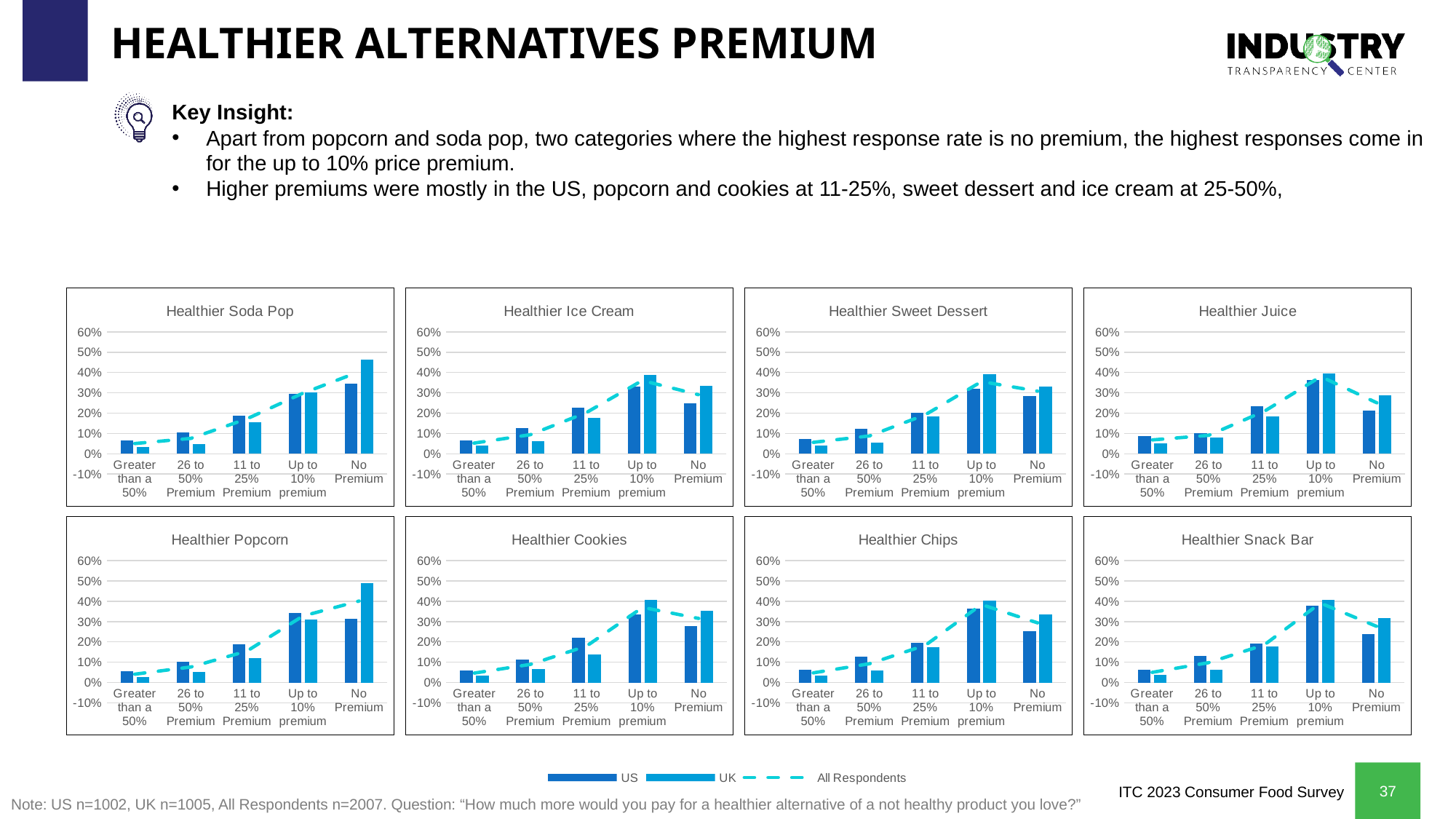
In the Healthier Juice chart, which category has the shortest UK bar? Greater than a 50% How many charts are shown on the slide? 8 In the Healthier Ice Cream chart, which is larger for the US: Up to 10% premium or No Premium? Up to 10% premium In the Healthier Soda Pop chart, which category has the tallest UK bar? No Premium How many categories are shown on the x axis of the Healthier Cookies chart? 5 In the Healthier Sweet Dessert chart, which is larger for the UK: Up to 10% premium or 26 to 50% Premium? Up to 10% premium In the Healthier Ice Cream chart, which category has the tallest UK bar? Up to 10% premium How many series does the legend at the bottom of the slide list? 3 What kind of chart is the Healthier Snack Bar chart? Bar chart with a dashed line In the Healthier Chips chart, is the US value for No Premium greater or less than 30%? less In the Healthier Soda Pop chart, is the UK value for No Premium greater or less than 40%? greater In the Healthier Popcorn chart, is the UK value for No Premium greater or less than 40%? greater